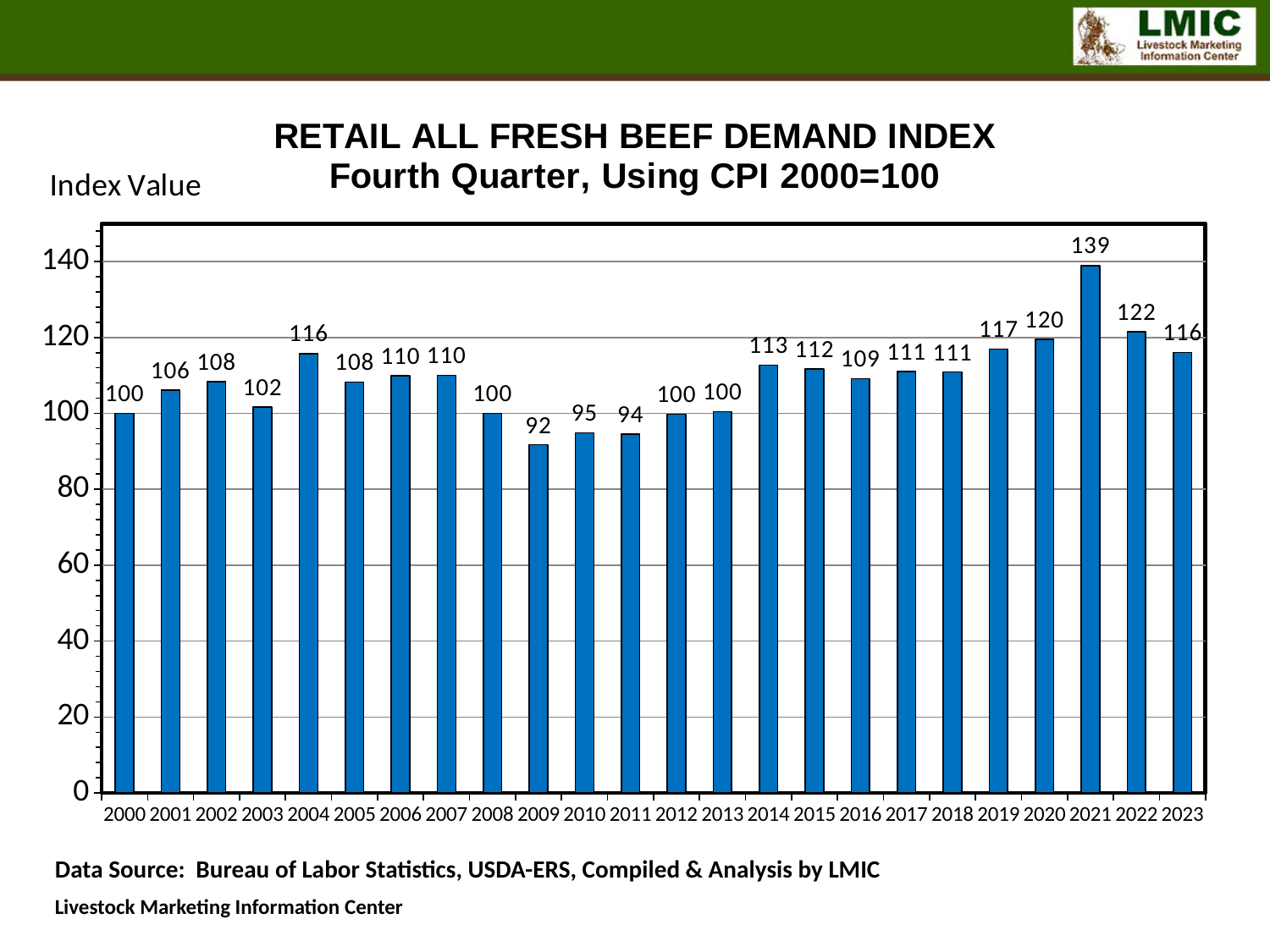
Is the value for 2020 greater or less than 100? greater Which year has the highest index value? 2021 Which year has the lowest index value? 2009 What is the difference between the index values for 2021 and 2022? 17 How many years are shown on the x axis? 24 Which year has a larger index value, 2004 or 2014? 2004 What is the index value for 2021? 139 What is the title of the chart? RETAIL ALL FRESH BEEF DEMAND INDEX Fourth Quarter, Using CPI 2000=100 What kind of chart is this? Bar chart What is the index value for 2023? 116 What is the index value for 2009? 92 Do the index values rise or fall from 2019 to 2021? Rise